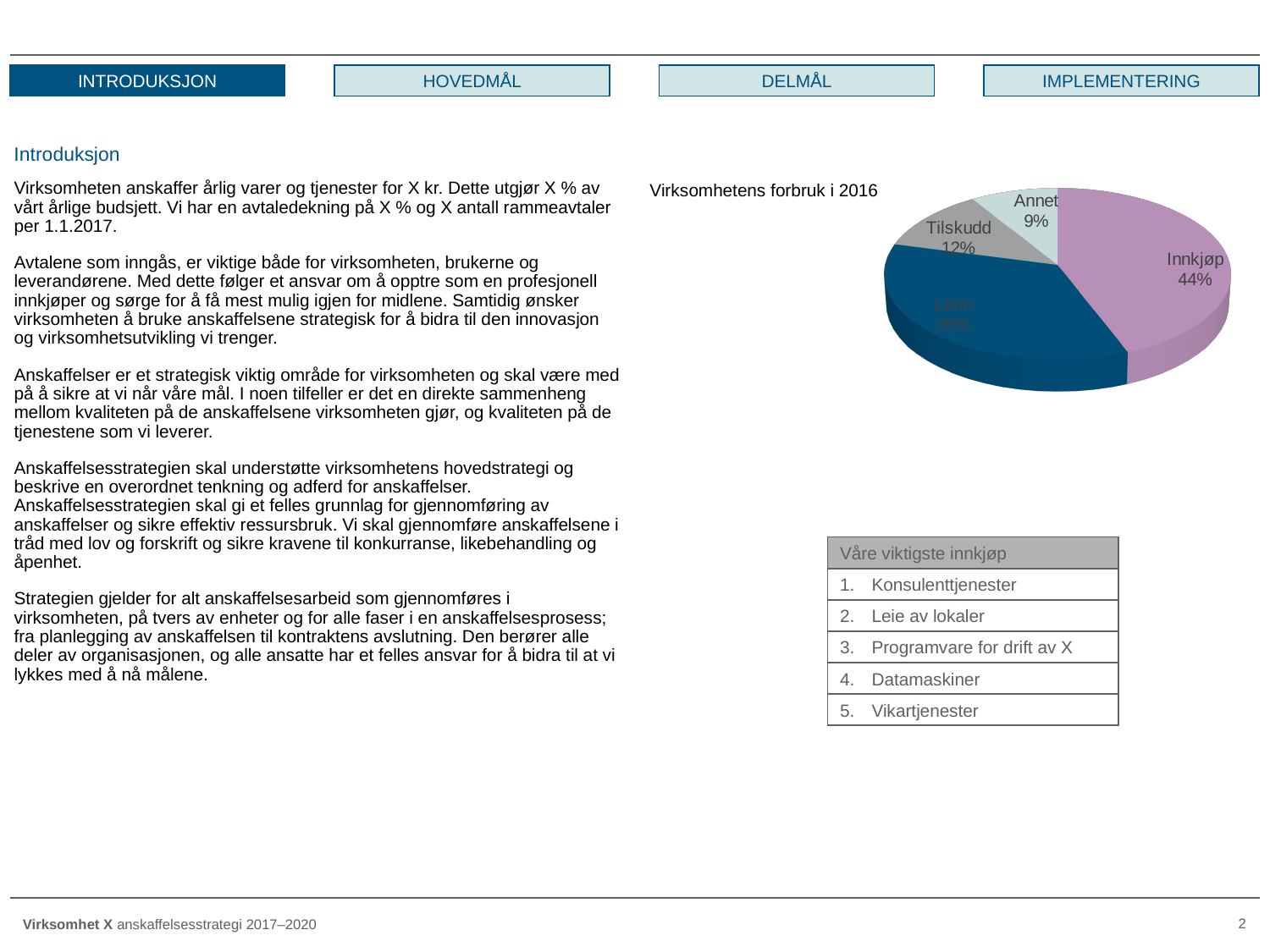
What share of the pie does Innkjøp represent? 44% Which is larger, the Innkjøp slice or the Tilskudd slice? Innkjøp Which is larger, the Innkjøp slice or the Annet slice? Innkjøp What kind of chart is shown on the slide? pie chart What is the title of the pie chart? Virksomhetens forbruk i 2016 How many percentage points larger is Innkjøp than Tilskudd? 32 What share of the pie does Annet represent? 9% How many percentage points larger is Tilskudd than Annet? 3 What share of the pie does Tilskudd represent? 12% What colour is the Innkjøp slice of the pie? purple Which labelled slice of the pie is the smallest? Annet How many slices does the pie chart have? 4